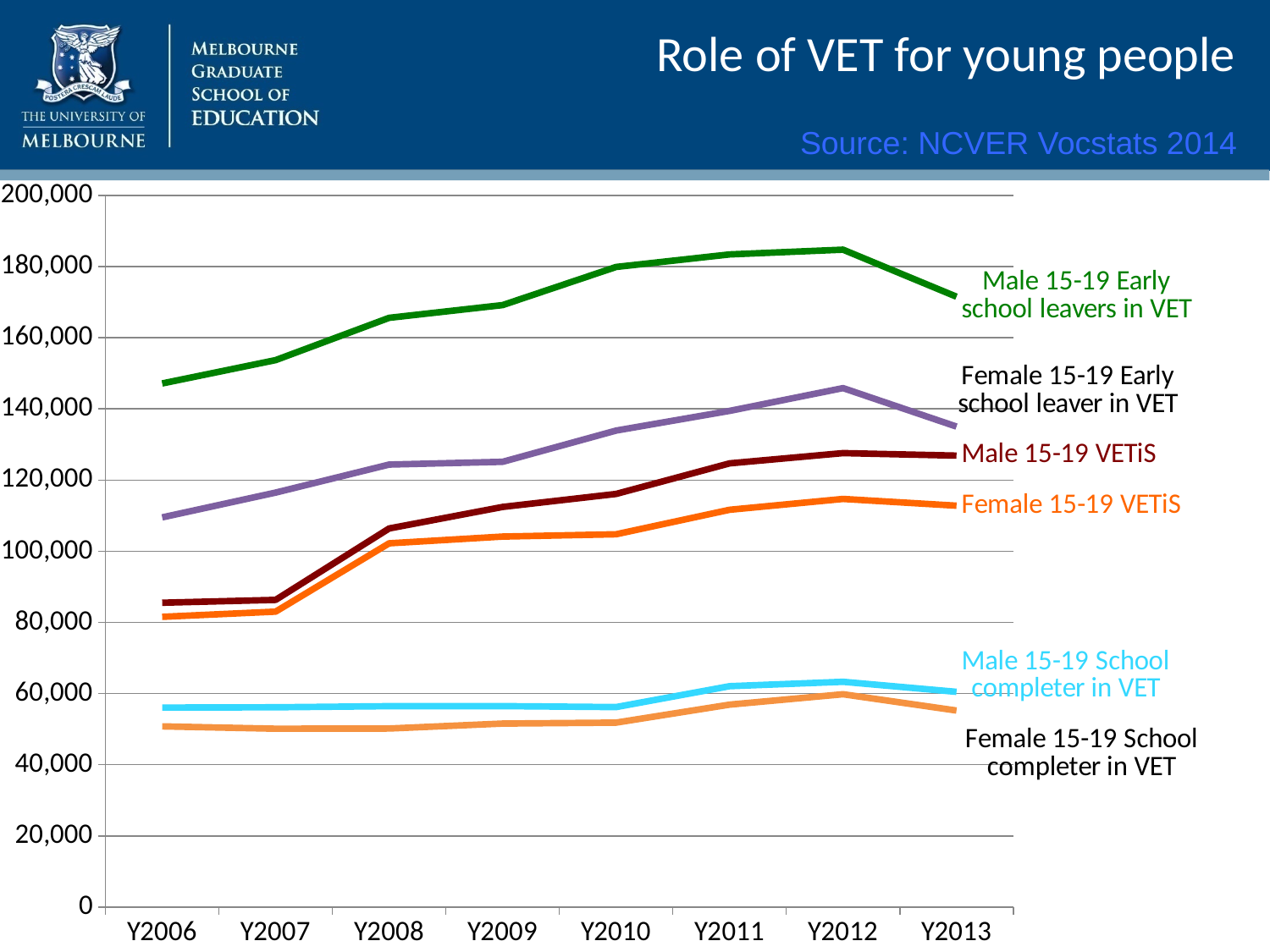
Which series has the lowest value in Y2006? Female 15-19 School completer in VET Is the value for Female 15-19 VETiS in Y2006 greater or less than 100,000? less How many years are shown along the x axis of the chart? 8 Is the value for Male 15-19 Early school leavers in VET in Y2010 greater or less than 160,000? greater Is the value for Female 15-19 Early school leaver in VET in Y2012 greater or less than 140,000? greater What source is cited for the chart data? NCVER Vocstats 2014 Which series has the highest value in Y2012? Male 15-19 Early school leavers in VET What kind of chart is shown on the slide? line chart In Y2013, which is larger: Male 15-19 VETiS or Female 15-19 VETiS? Male 15-19 VETiS Do the values for Female 15-19 Early school leaver in VET rise or fall from Y2012 to Y2013? fall Do the values for Male 15-19 Early school leavers in VET rise or fall from Y2006 to Y2012? rise How many series are plotted on the chart? 6